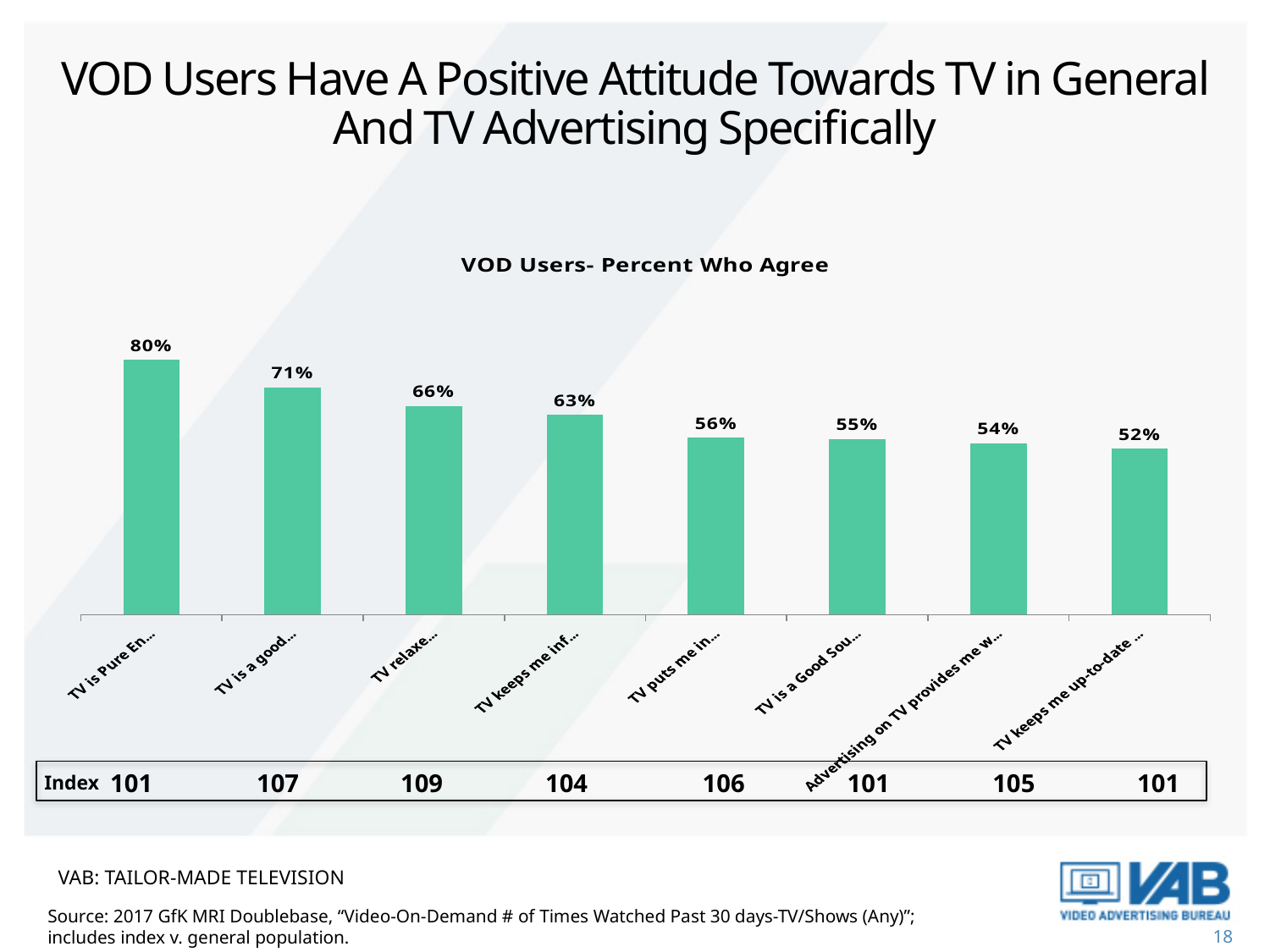
Do the bar values rise or fall from left to right across the chart? fall Which bar has the lowest value? TV keeps me up-to-date ... (the last bar) How many bars are plotted in the chart? 8 What is the value of the first (leftmost) bar, labelled "TV is Pure En..."? 80% What is the value of the bar labelled "TV relaxe..."? 66% What is the value of the last (rightmost) bar, labelled "TV keeps me up-to-date ..."? 52% What is the title of the chart? VOD Users- Percent Who Agree Which is larger: the value for "TV keeps me inf..." or the value for "TV puts me in..."? TV keeps me inf... (63%) What type of chart is shown on the slide? bar chart Which bar has the highest value? TV is Pure En... (the first bar) What is the difference between the highest bar (80%) and the lowest bar (52%)? 28 percentage points What index value is shown beneath the bar labelled "TV relaxe..."? 109